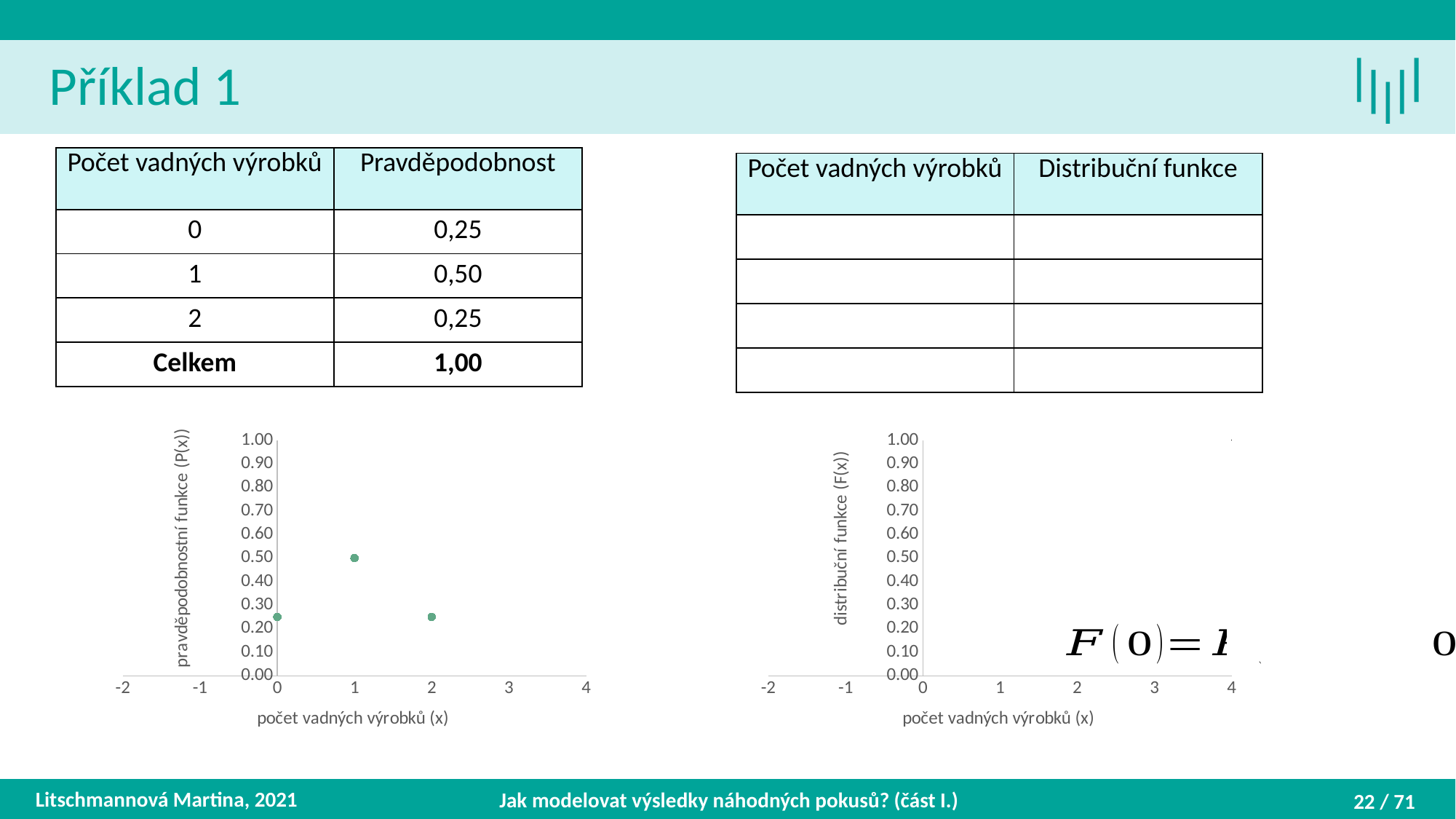
What kind of chart is the left chart? scatter chart On the left chart, which value of x has the highest plotted probability? 1 On the left chart, which is larger: the value at x = 1 or the value at x = 2? x = 1 How many data points are plotted on the left chart? 3 On the left chart, is the value at x = 2 greater or less than 0.30? less On the left chart, what is the value of the probability function at x = 1? 0.50 What is the y-axis label of the right chart? distribuční funkce (F(x)) On the left chart, do the plotted values rise or fall from x = 1 to x = 2? fall On the left chart, is the value at x = 0 greater or less than 0.20? greater On the left chart, is the value at x = 1 greater or less than 0.40? greater What is the y-axis label of the left chart? pravděpodobnostní funkce (P(x))